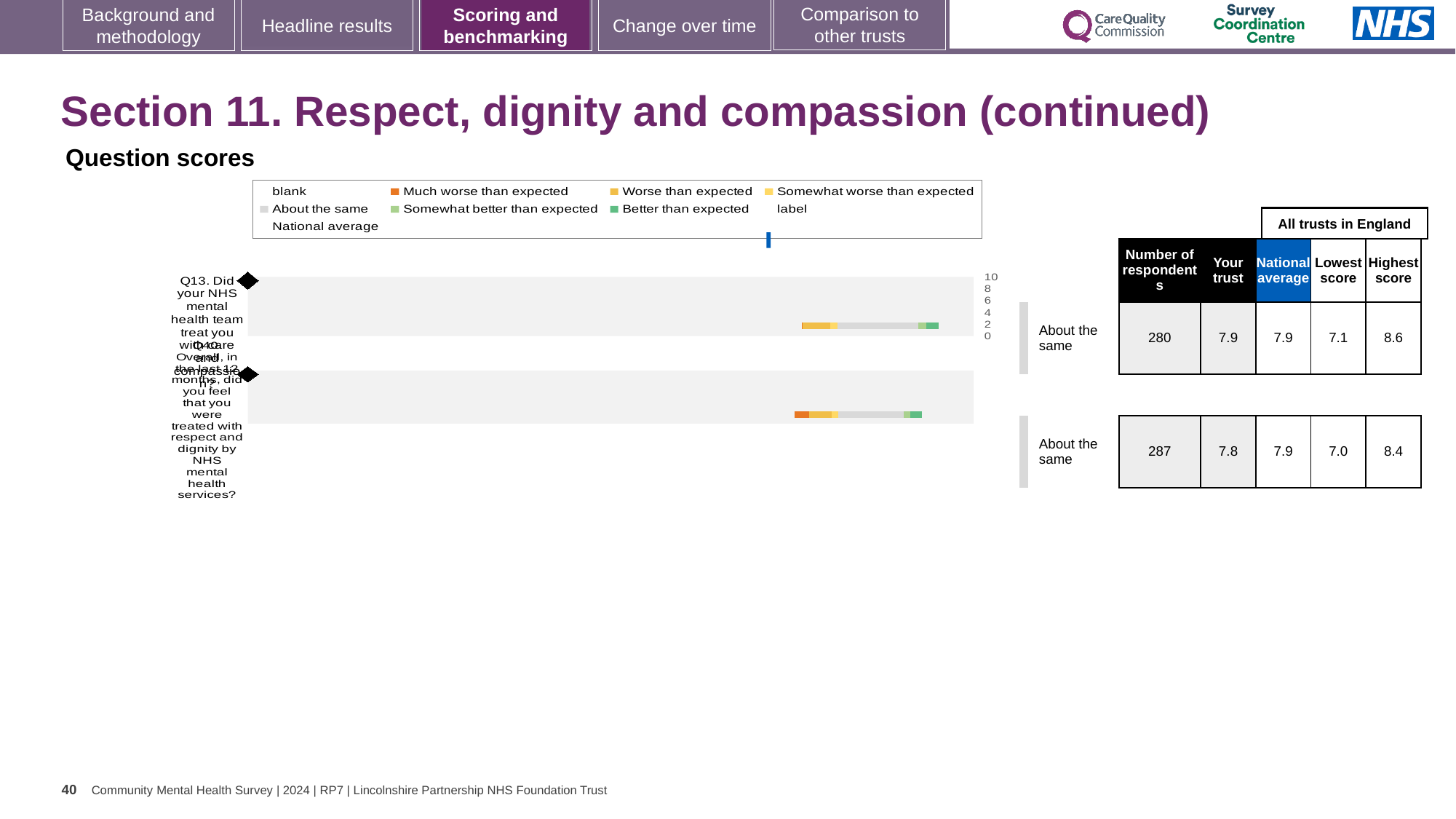
How many survey questions are plotted in the chart? 2 In the table beside the chart, how many respondents are listed for Q14? 287 What is the heading above the chart? Question scores In the table beside the chart, what is the lowest score for Q14? 7.0 What benchmark category is shown next to the chart for Q14? About the same In the table beside the chart, what is the difference between the highest score and the lowest score for Q13? 1.5 What is the highest value shown on the chart's axis? 10 Which question has the higher "Your trust" score in the table beside the chart, Q13 or Q14? Q13 In the table beside the chart, what is the national average for Q14? 7.9 In the table beside the chart, what is the "Your trust" score for Q13? 7.9 How many entries does the chart legend list? 9 What kind of chart is shown under the heading "Question scores"? bar chart